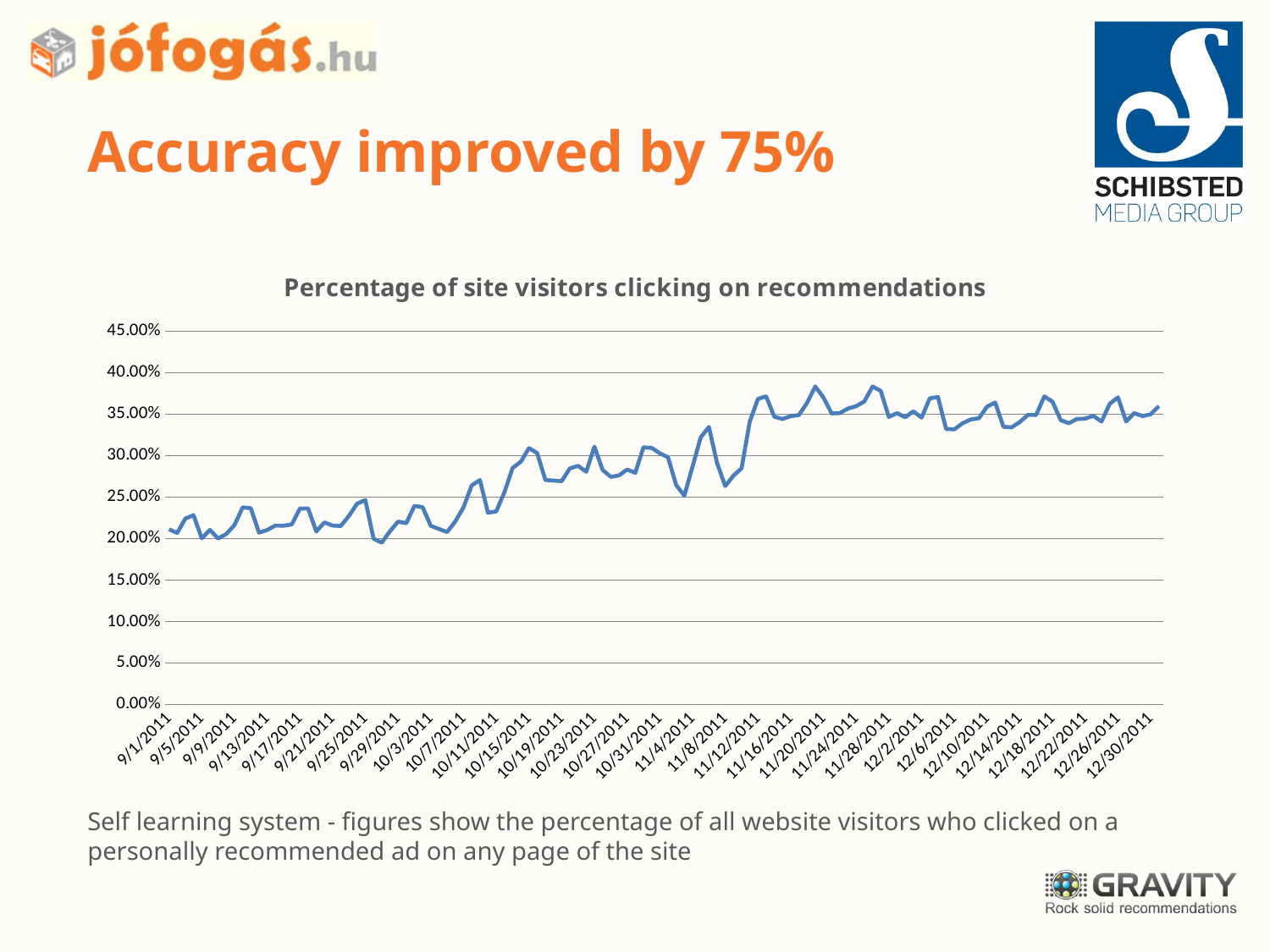
What kind of chart is shown on the slide? line chart What is the title of the chart? Percentage of site visitors clicking on recommendations Is the value for 10/7/2011 greater or less than 25.00%? less Which is larger, the value for 9/1/2011 or the value for 12/30/2011? 12/30/2011 Is the value for 12/30/2011 greater or less than 30.00%? greater Is the value for 9/1/2011 greater or less than 25.00%? less Which is larger, the value for 9/29/2011 or the value for 11/16/2011? 11/16/2011 What is the highest value shown on the y axis? 45.00% Do the values generally rise or fall from 9/1/2011 to 12/30/2011? rise